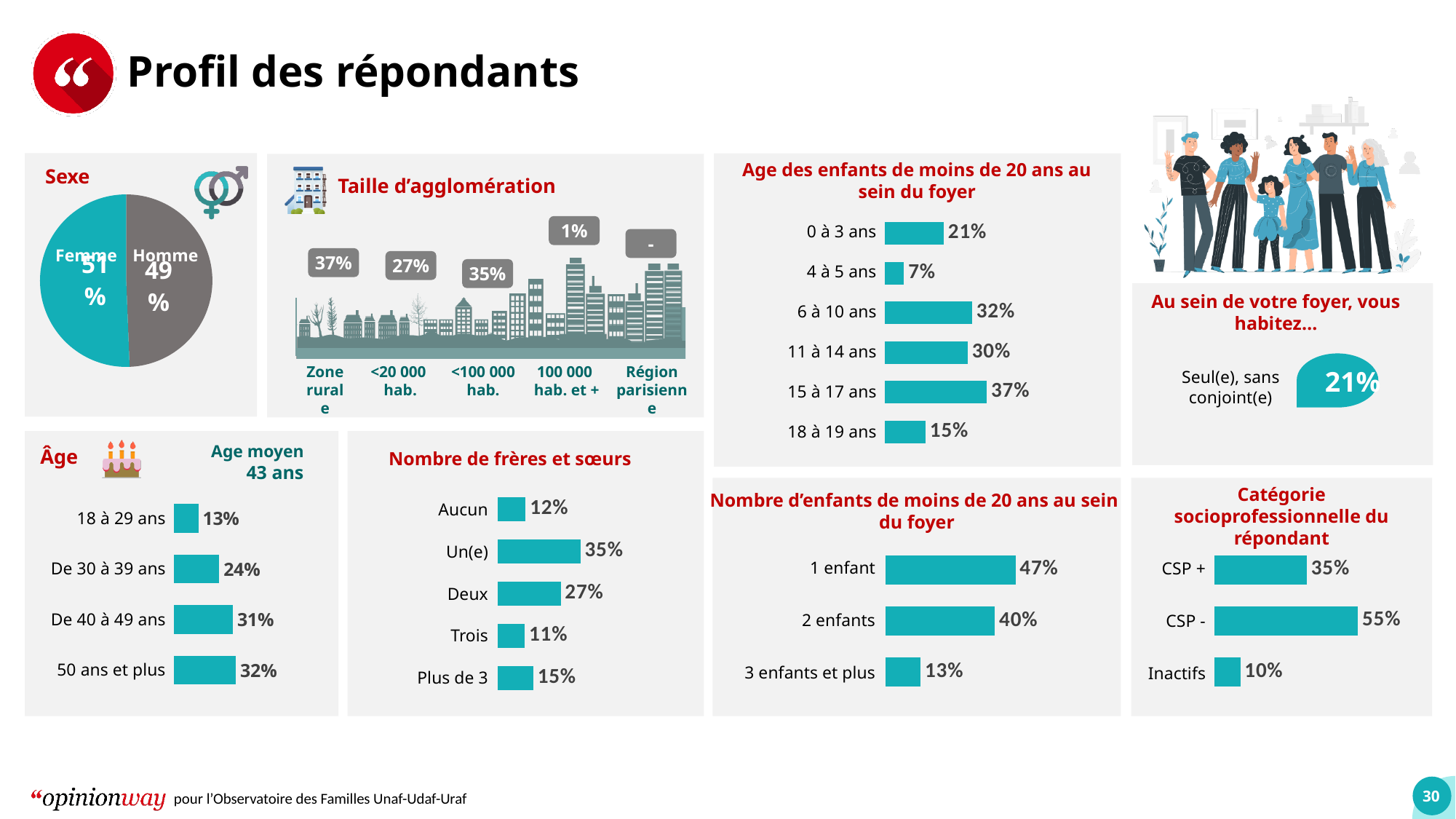
In the 'Sexe' pie chart, what share is Femme? 51% In the 'Age des enfants de moins de 20 ans au sein du foyer' chart, how many age categories are shown? 6 In the 'Age des enfants de moins de 20 ans au sein du foyer' chart, what is the value for '15 à 17 ans'? 37% In the 'Catégorie socioprofessionnelle du répondant' chart, what is the difference between 'CSP -' and 'CSP +'? 20% In the 'Nombre d'enfants de moins de 20 ans au sein du foyer' chart, what is the value for '2 enfants'? 40% In the 'Âge' chart, which age group has the lowest value? 18 à 29 ans In the 'Taille d'agglomération' chart, what is the value for 'Zone rurale'? 37% In the 'Nombre de frères et sœurs' chart, what is the difference between 'Deux' and 'Trois'? 16% In the 'Age des enfants de moins de 20 ans au sein du foyer' chart, which is larger, '6 à 10 ans' or '11 à 14 ans'? 6 à 10 ans In the 'Nombre de frères et sœurs' chart, which category has the highest value? Un(e) In the 'Âge' chart, what is the value for 'De 40 à 49 ans'? 31% What kind of chart is used for 'Sexe'? pie chart